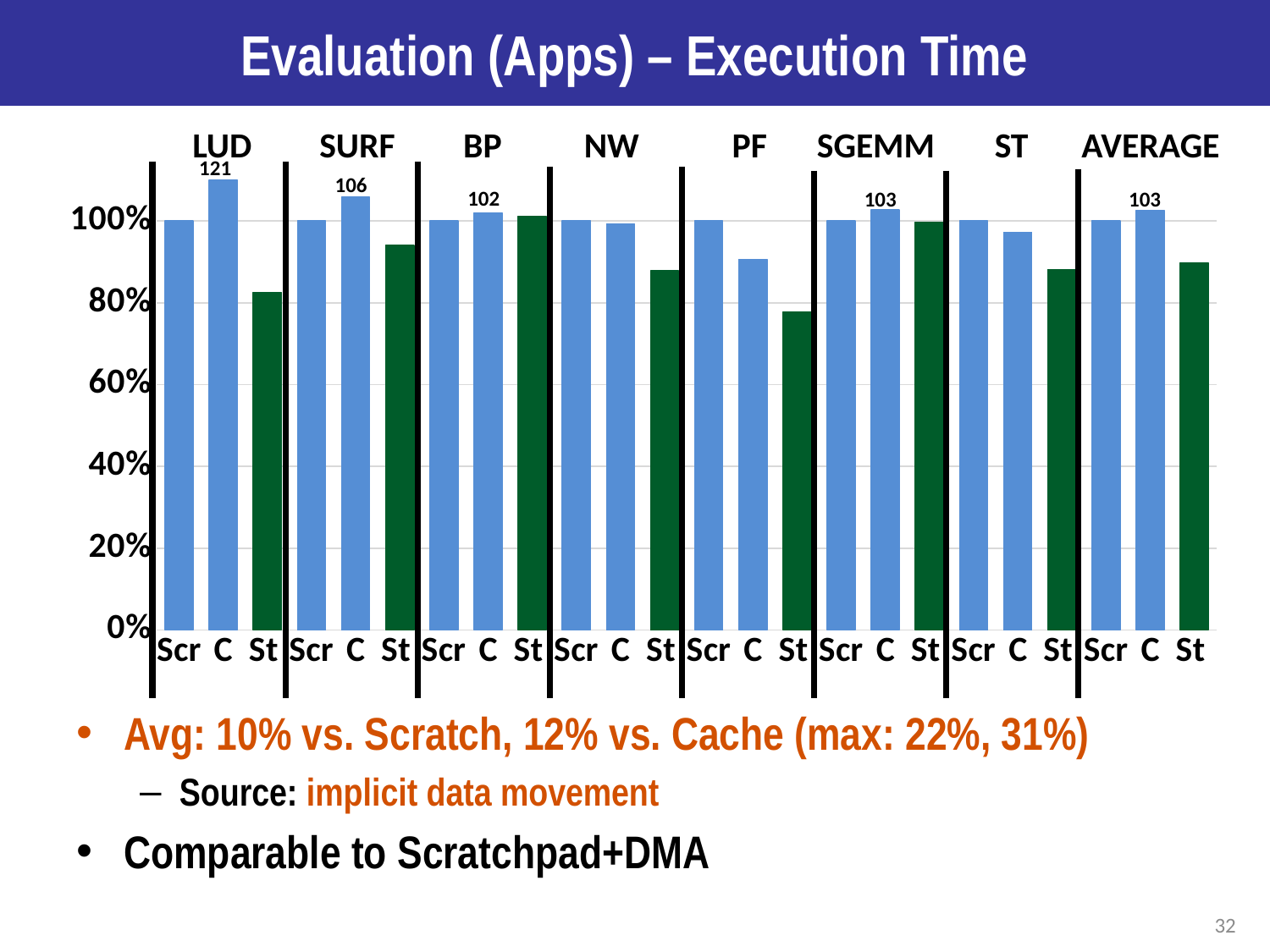
Which application group has the highest C bar? LUD What kind of chart is shown on the slide? Bar chart How many application groups are shown on the x axis? 8 What is the value of the C bar for SGEMM? 103 What is the value of the C bar for SURF? 106 Is the St bar for LUD greater or less than 100%? less What is the difference between the C bar for LUD and the C bar for SURF? 15 What is the value of the C bar for BP? 102 Which is larger, the C bar for LUD or the C bar for SURF? LUD Is the St bar for SGEMM greater or less than 80%? greater What is the value of the C bar for LUD? 121 What is the value of the C bar for AVERAGE? 103